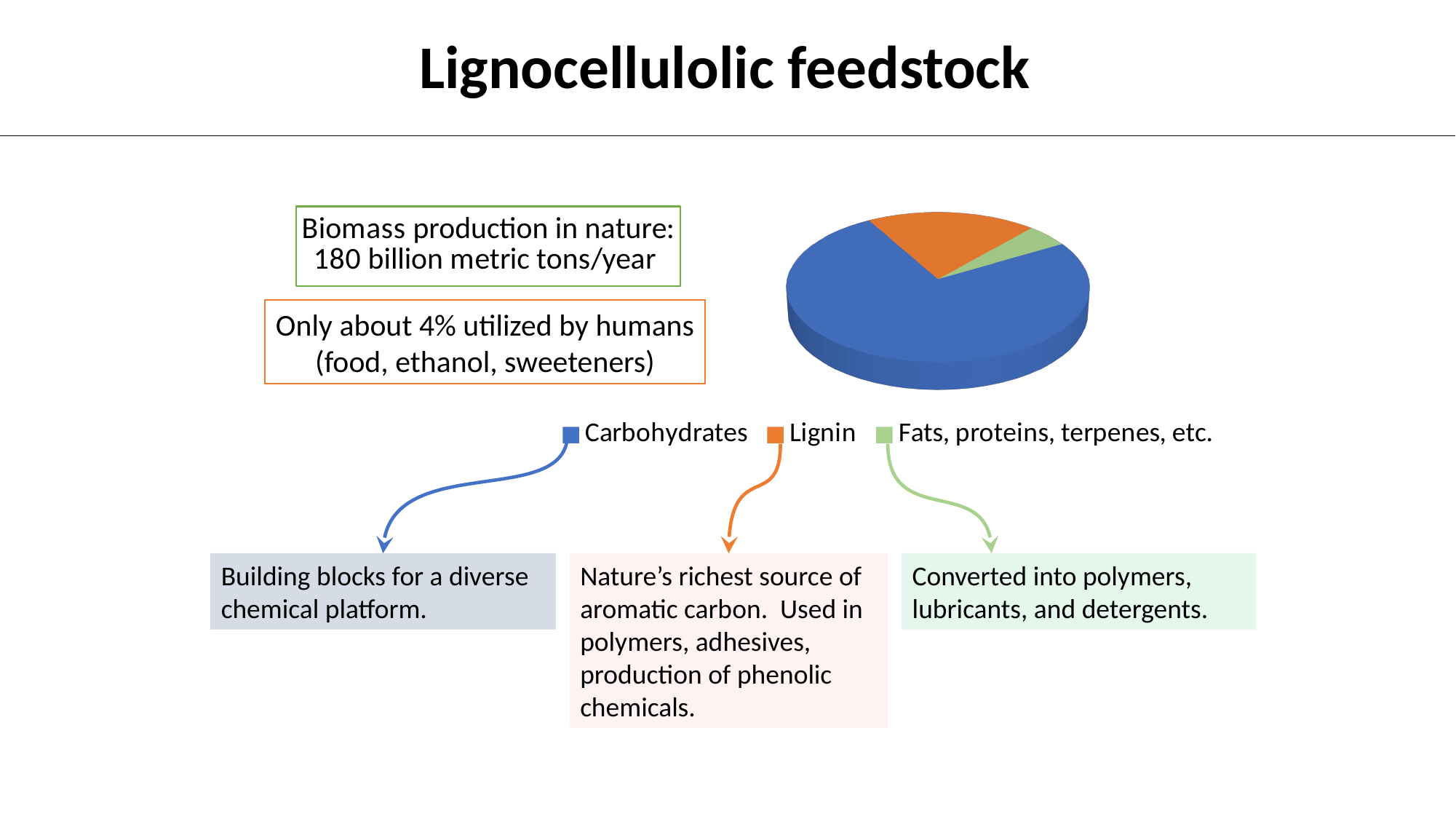
Is the Carbohydrates slice more or less than half of the pie? more Which slice is larger: Lignin or Fats, proteins, terpenes, etc.? Lignin How many slices does the pie chart have? 3 Which slice is larger: Carbohydrates or Lignin? Carbohydrates What colour represents Lignin in the pie chart? orange Which category has the largest slice of the pie chart? Carbohydrates Which category has the smallest slice of the pie chart? Fats, proteins, terpenes, etc. What kind of chart is shown on the slide? pie chart What colour represents Carbohydrates in the pie chart? blue How many entries does the legend of the pie chart list? 3 Which category has the second-largest slice of the pie chart? Lignin